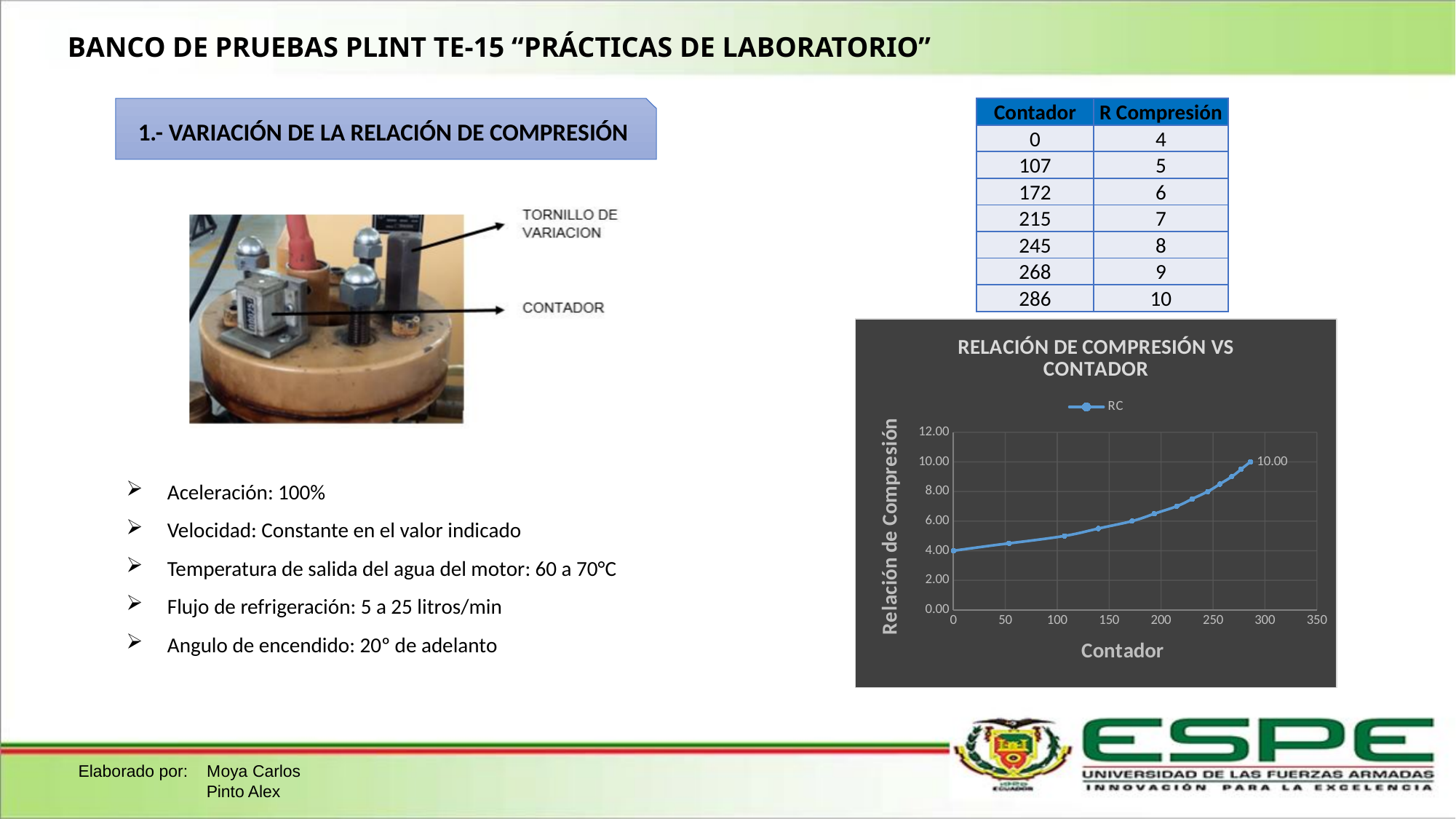
What is the name of the series shown in the chart legend? RC How many series does the chart legend list? 1 Which is larger, the RC value at Contador 0 or at Contador 286? Contador 286 What kind of chart is shown on the slide? line chart Is the RC value at Contador 250 greater or less than 6.00? greater What value is printed as a data label at the last point of the RC line? 10.00 At which Contador value does the RC line reach its highest point? 286 What is the title of the chart? RELACIÓN DE COMPRESIÓN VS CONTADOR Do the RC values rise or fall as Contador increases along the x axis? rise Is the RC value at Contador 100 greater or less than 8.00? less At which Contador value does the RC line have its lowest point? 0 Is the RC value at Contador 0 greater or less than 6.00? less